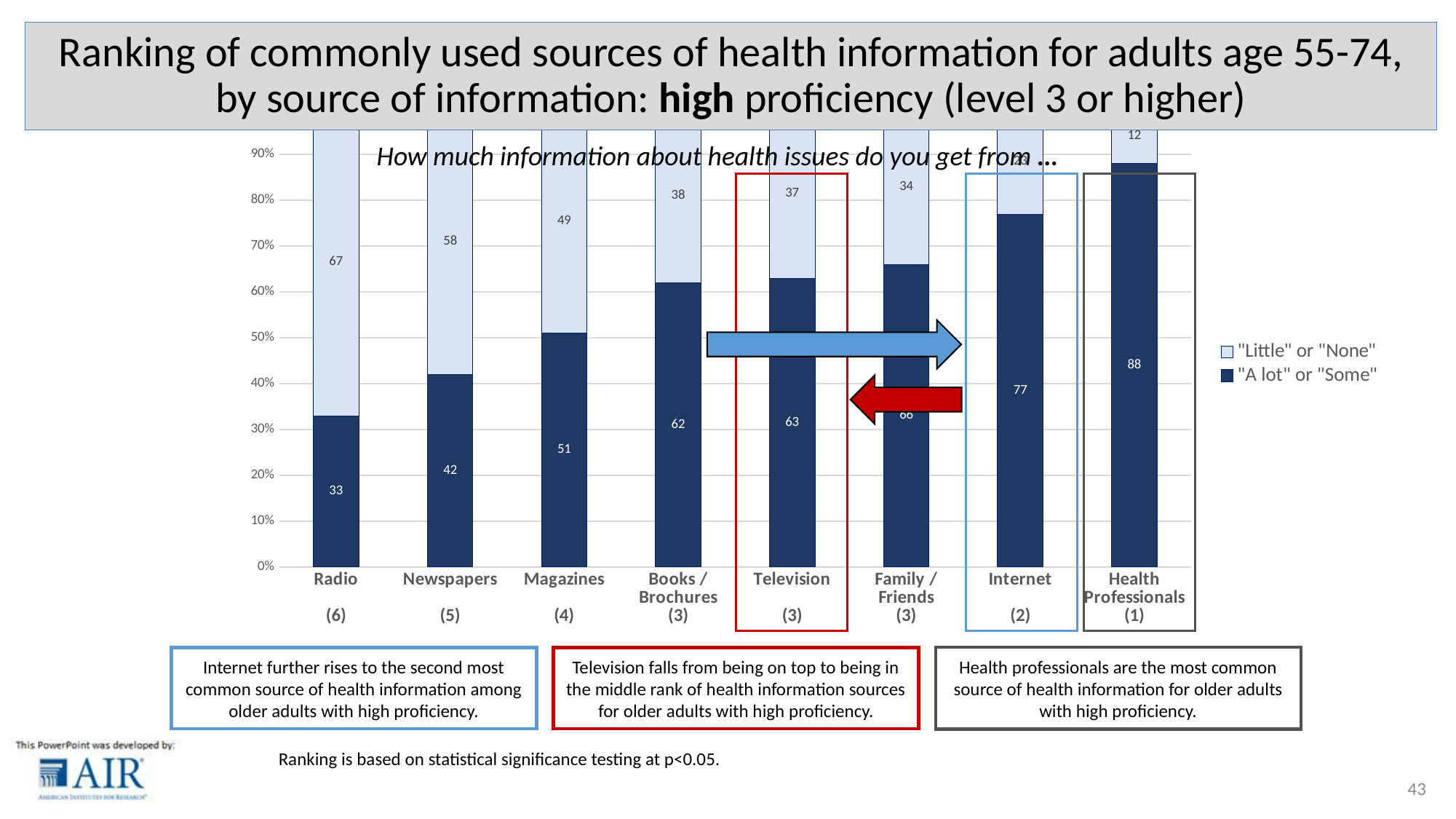
Which has a larger "A lot" or "Some" value, Magazines or Books / Brochures? Books / Brochures What is the "A lot" or "Some" value for Health Professionals? 88 Which source has the lowest "A lot" or "Some" value? Radio What is the "Little" or "None" value for Newspapers? 58 Which source has the highest "A lot" or "Some" value? Health Professionals How many sources of health information are shown on the x axis? 8 How many series does the legend list? 2 What kind of chart is shown on the slide? stacked bar chart What is the "A lot" or "Some" value for Radio? 33 What is the "Little" or "None" value for Television? 37 Is the "A lot" or "Some" value for Newspapers greater or less than 50%? less What is the difference between the "A lot" or "Some" values for Internet and Television? 14